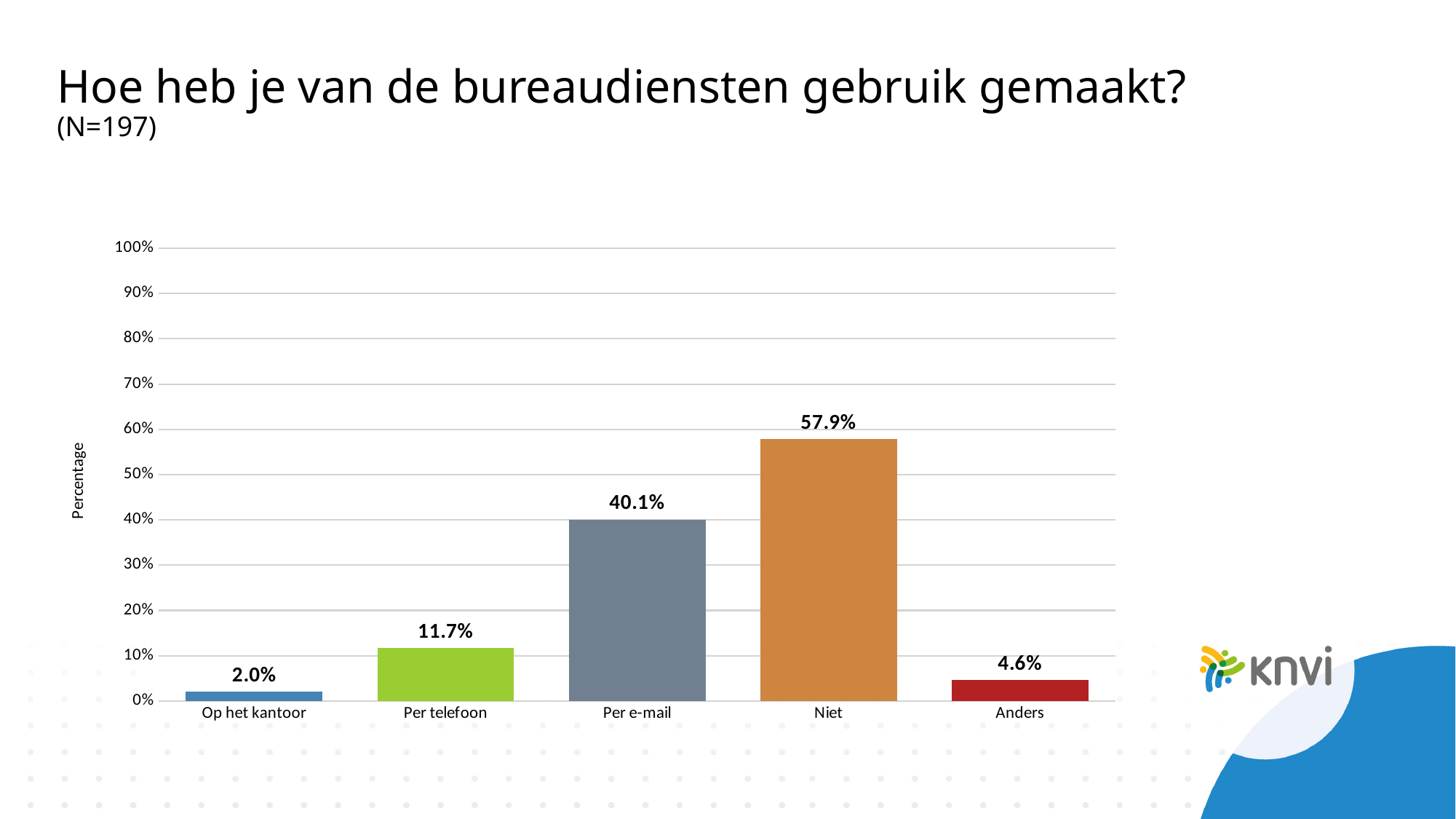
Is the value for Niet greater or less than 50%? greater How many categories are shown on the x axis? 5 What is the value for Anders? 4.6% Which category has the lowest value? Op het kantoor What is the difference between the values for Per telefoon and Anders? 7.1% What is the difference between the values for Niet and Per e-mail? 17.8% What is the value for Per e-mail? 40.1% Which is larger, the value for Per telefoon or the value for Anders? Per telefoon What is the value for Op het kantoor? 2.0% What kind of chart is shown on the slide? bar chart Which category has the highest value? Niet What is the label of the vertical axis? Percentage